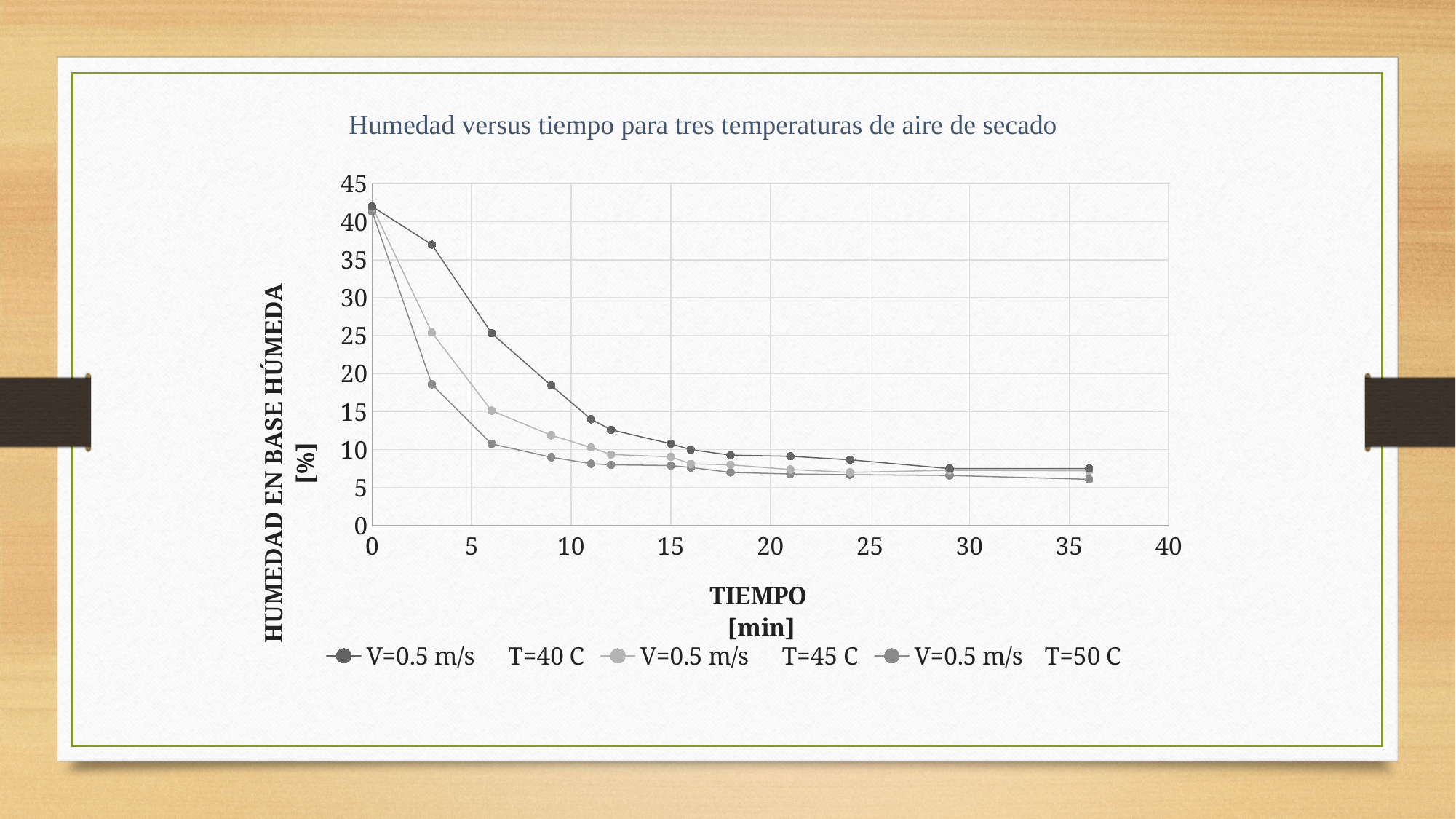
What is the label of the x axis? TIEMPO [min] Is the value for the series V=0.5 m/s T=40 C at 3 min greater or less than 35? greater Is the value for the series V=0.5 m/s T=40 C at 9 min greater or less than 20? less Is the value for the series V=0.5 m/s T=50 C at 36 min greater or less than 5? greater Do the values of the series rise or fall as time increases along the x axis? fall What kind of chart is shown on the slide? line chart At 6 min, which series has the lowest value? V=0.5 m/s T=50 C At 3 min, which series has the larger value: V=0.5 m/s T=40 C or V=0.5 m/s T=50 C? V=0.5 m/s T=40 C How many series does the legend list? 3 What is the title of the chart? Humedad versus tiempo para tres temperaturas de aire de secado